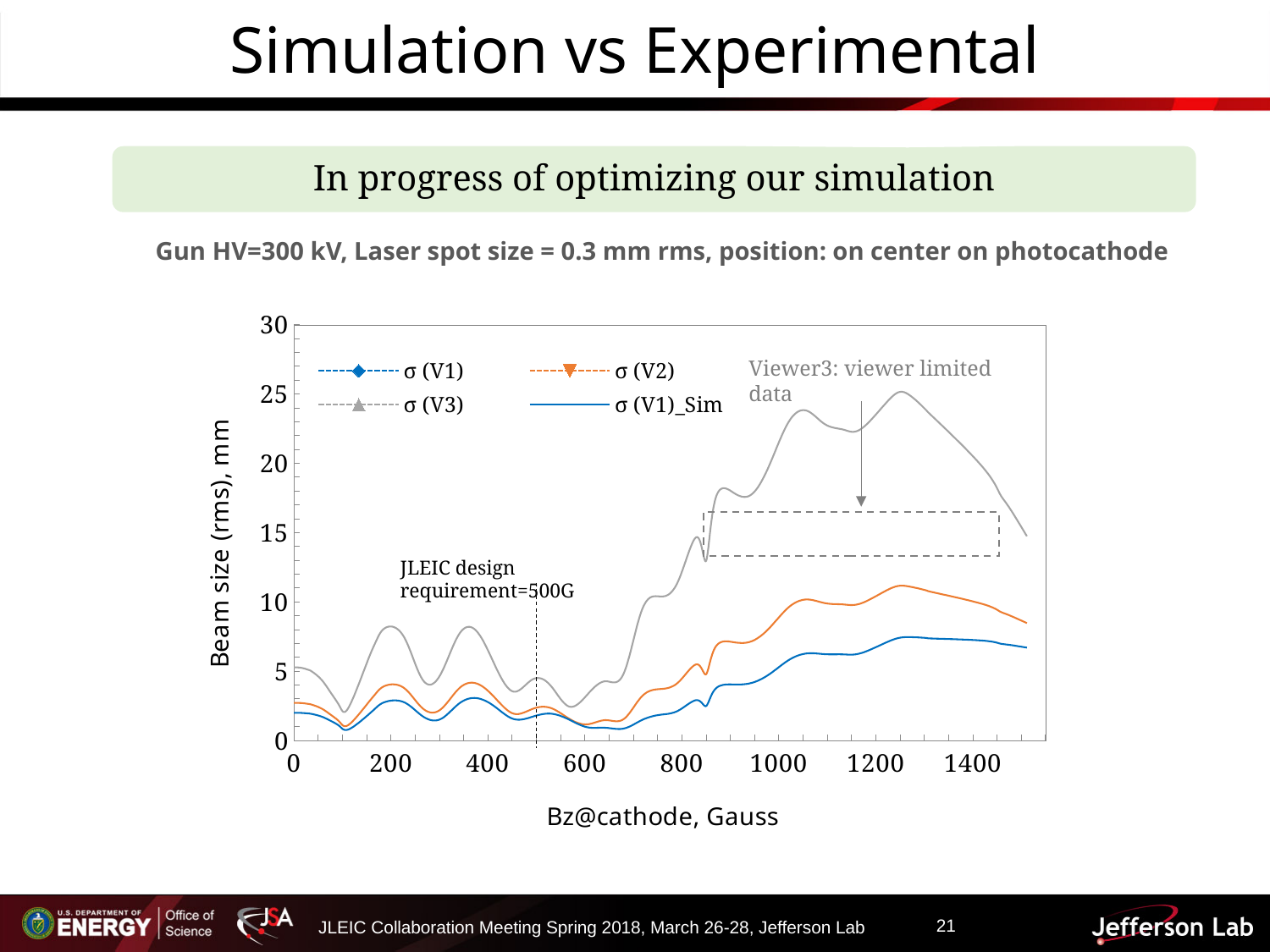
Is the value for σ (V2) at 1200 Gauss greater or less than 5? greater Which series reaches the highest beam size on the chart? σ (V3) Is the value for σ (V1) at 1400 Gauss greater or less than 10? less What is the label of the y axis of the chart? Beam size (rms), mm Overall, do the beam size values rise or fall as Bz@cathode increases from 0 to 1200 Gauss? rise At 1000 Gauss, which is larger: the value for σ (V3) or the value for σ (V1)? σ (V3) Which series has the lowest beam size at 1400 Gauss? σ (V1)_Sim How many series does the chart legend list? 4 At 1200 Gauss, which is larger: the value for σ (V2) or the value for σ (V1)_Sim? σ (V2) What kind of chart is shown on the slide? line chart What is the label of the x axis of the chart? Bz@cathode, Gauss